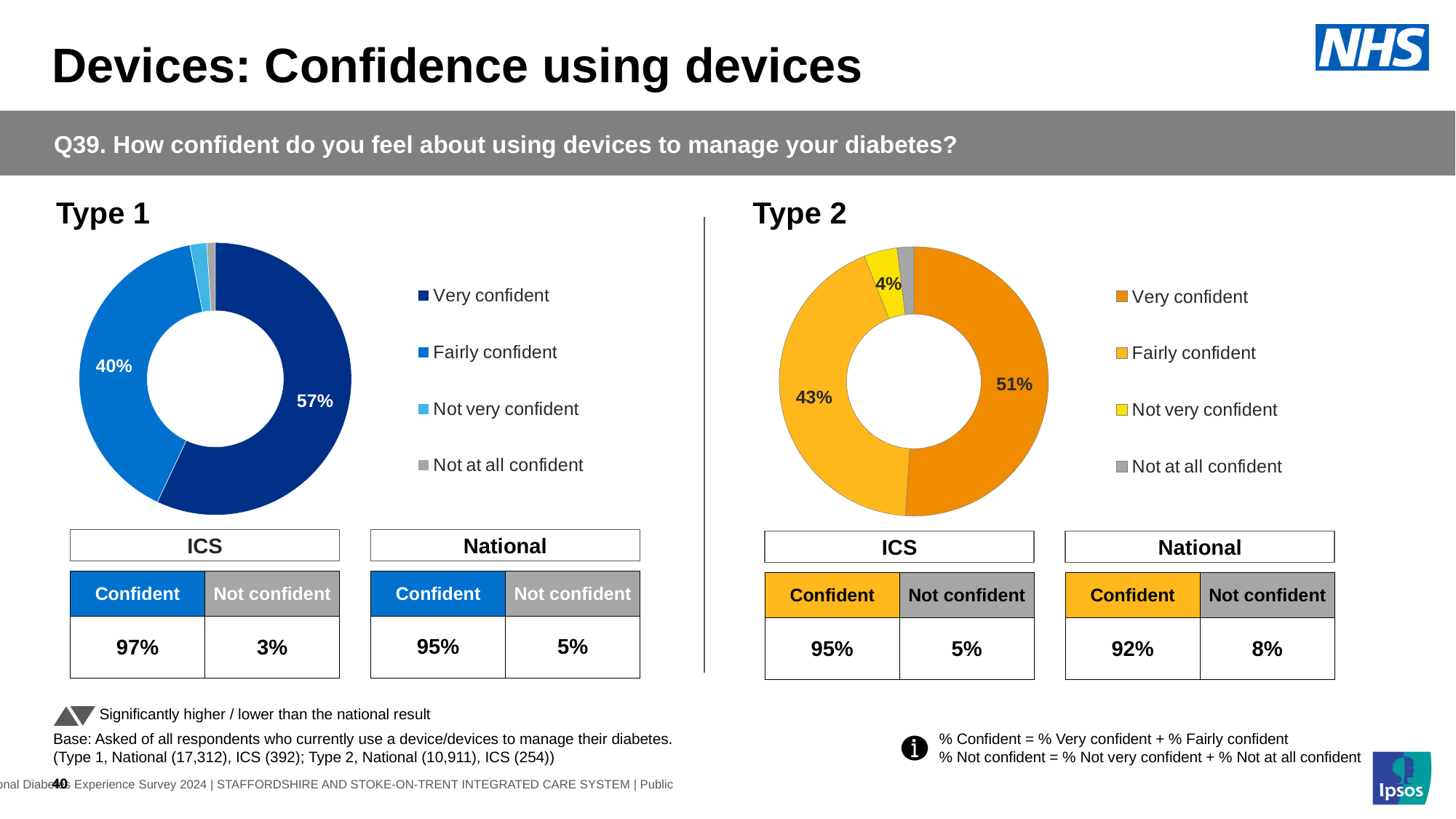
On the Type 1 chart, what percentage of respondents are Very confident? 57% How many categories does the legend of the Type 1 chart list? 4 On the Type 1 chart, what percentage of respondents are Fairly confident? 40% On the Type 2 chart, what is the difference between the Very confident and Fairly confident shares? 8% On the Type 2 chart, what percentage of respondents are Not very confident? 4% On the Type 1 chart, what is the difference between the Very confident and Fairly confident shares? 17% On the Type 2 chart, which category has the largest share? Very confident On the Type 2 chart, what percentage of respondents are Fairly confident? 43% On the Type 1 chart, which category has the largest share? Very confident What kind of chart is used for Type 2? Donut (pie) chart Which is larger: the Very confident share on the Type 1 chart or the Very confident share on the Type 2 chart? Type 1 On the Type 2 chart, what percentage of respondents are Very confident? 51%